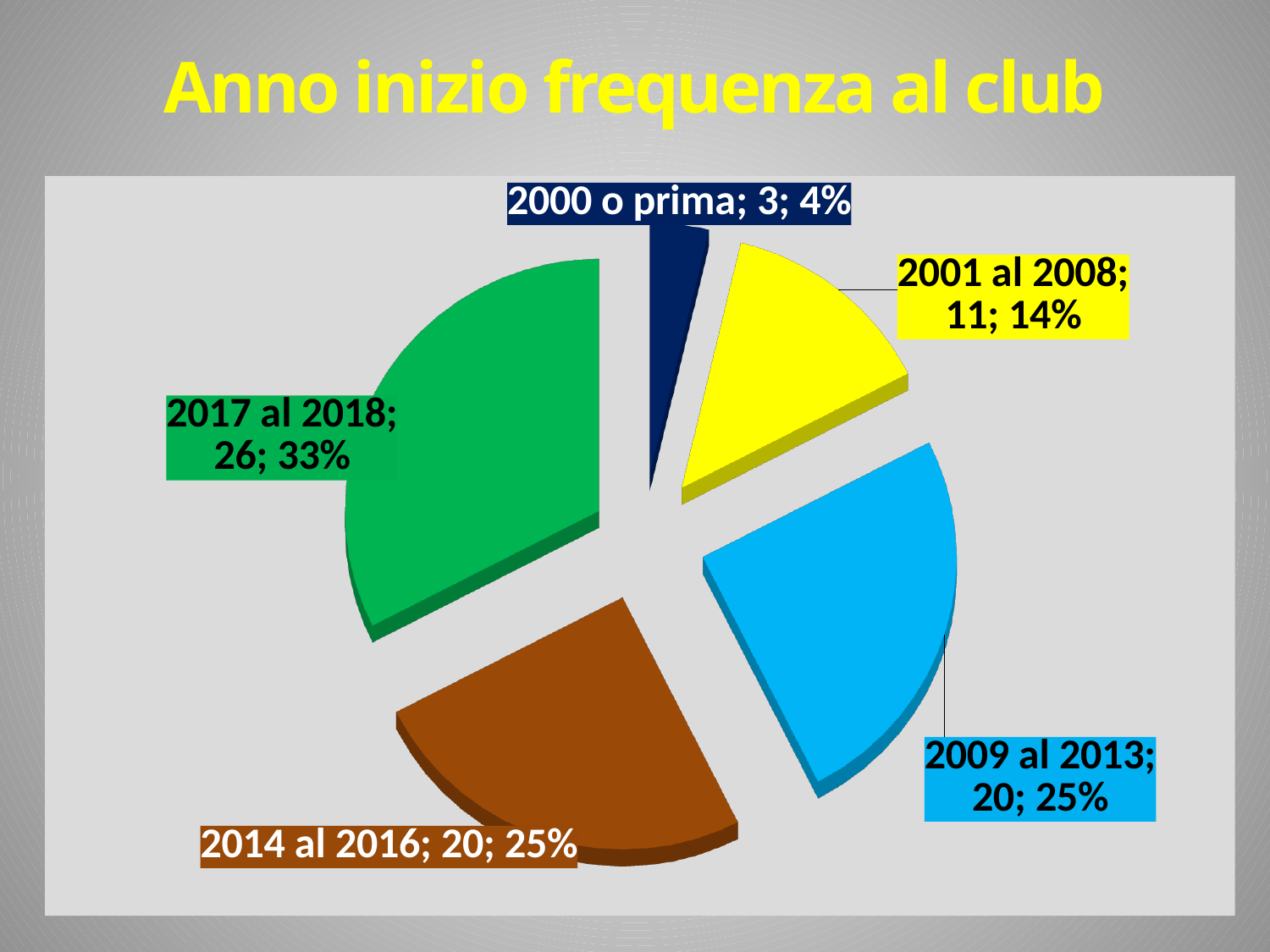
Which category has the largest slice? 2017 al 2018 Which category has the smallest slice? 2000 o prima What percentage share does "2001 al 2008" have? 14% Which is larger, the value for "2001 al 2008" or the value for "2014 al 2016"? 2014 al 2016 What is the value for "2017 al 2018"? 26 What colour is the slice for "2014 al 2016"? brown What kind of chart is shown on the slide? pie chart What percentage share does "2009 al 2013" have? 25% What is the value for "2000 o prima"? 3 How many slices does the pie chart have? 5 What is the difference between the values for "2017 al 2018" and "2009 al 2013"? 6 What is the title of the chart? Anno inizio frequenza al club